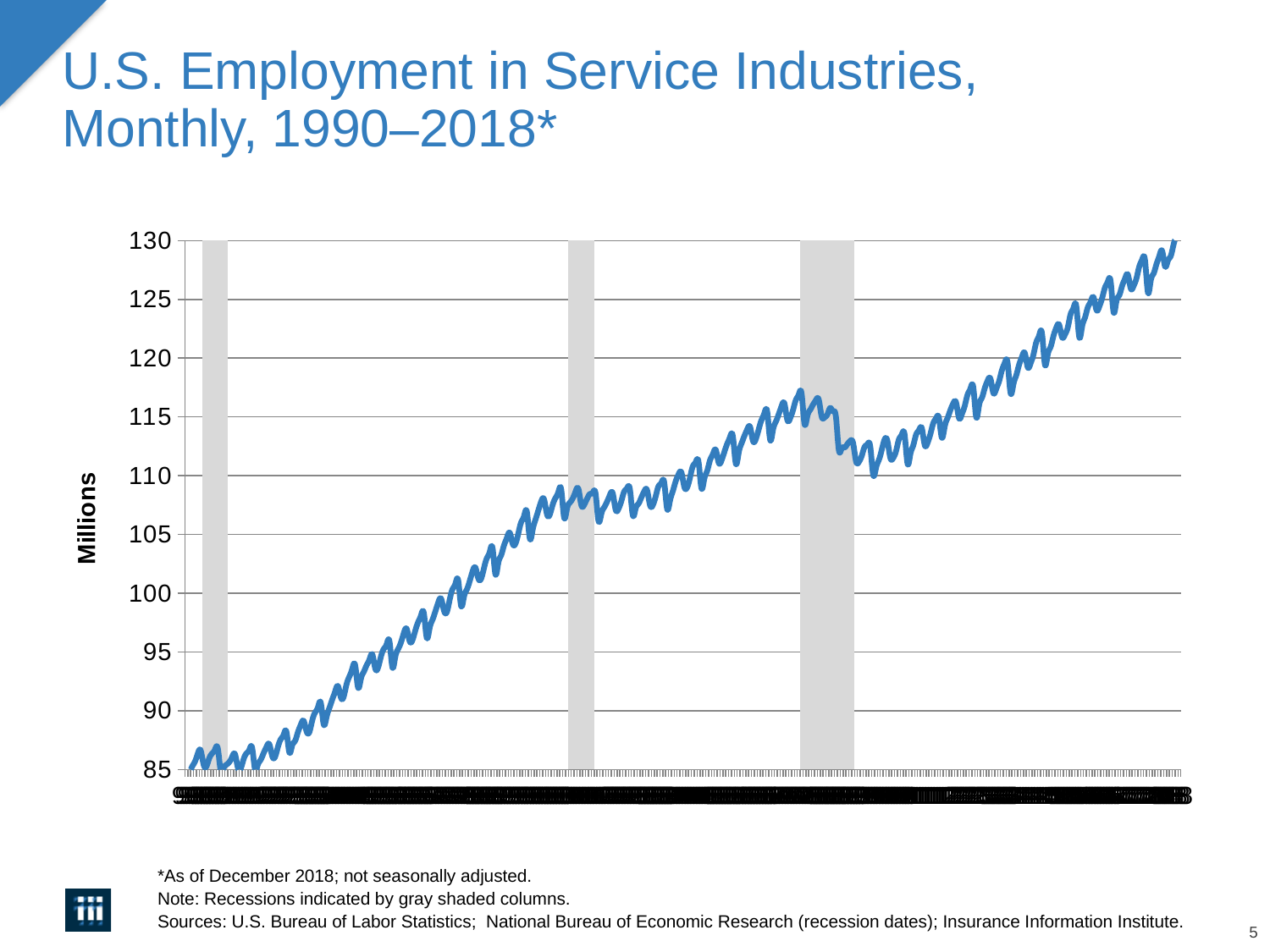
What is the highest tick value shown on the vertical axis? 130 What is the label on the vertical axis? Millions Is the value at the start of the series (1990) greater or less than 90? less Is the value at the end of the series (December 2018) greater or less than 125? greater What kind of chart is shown on the slide? line chart How many gray shaded recession columns are shown on the chart? 3 Is the peak value reached just before the third gray shaded recession column greater or less than 120? less Overall, do the values rise or fall from 1990 to 2018? rise Which is larger: the value at the end of the series in 2018 or the value at the start of the series in 1990? the value at the end of the series in 2018